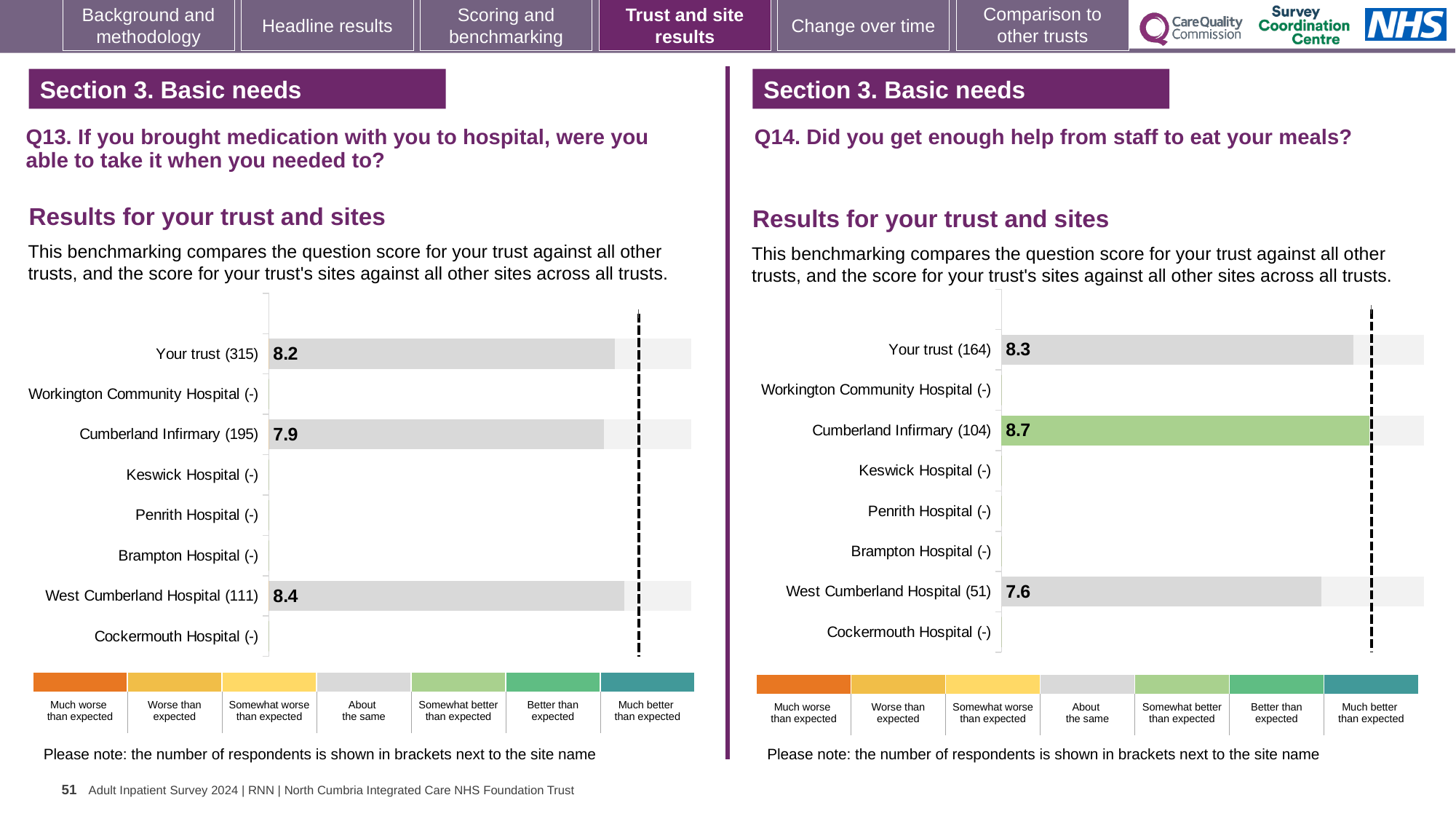
How many site or trust rows are listed on the Q13 chart (left)? 8 On the Q13 chart (left), what is the score for Your trust? 8.2 On the Q14 chart (right), what is the difference between the Cumberland Infirmary score and the West Cumberland Hospital score? 1.1 On the Q14 chart (right), which row has the lowest score among those with a value shown? West Cumberland Hospital On the Q14 chart (right), is the score for Cumberland Infirmary larger or smaller than the score for Your trust? larger What type of chart is used on the Q14 chart (right)? bar chart On the Q14 chart (right), what is the score for Cumberland Infirmary? 8.7 On the Q13 chart (left), what is the score for Cumberland Infirmary? 7.9 On the Q13 chart (left), what is the difference between the West Cumberland Hospital score and the Cumberland Infirmary score? 0.5 On the Q14 chart (right), what is the score for West Cumberland Hospital? 7.6 On the Q13 chart (left), which site or trust row has the highest score? West Cumberland Hospital On the Q13 chart (left), how many respondents are shown for Your trust? 315